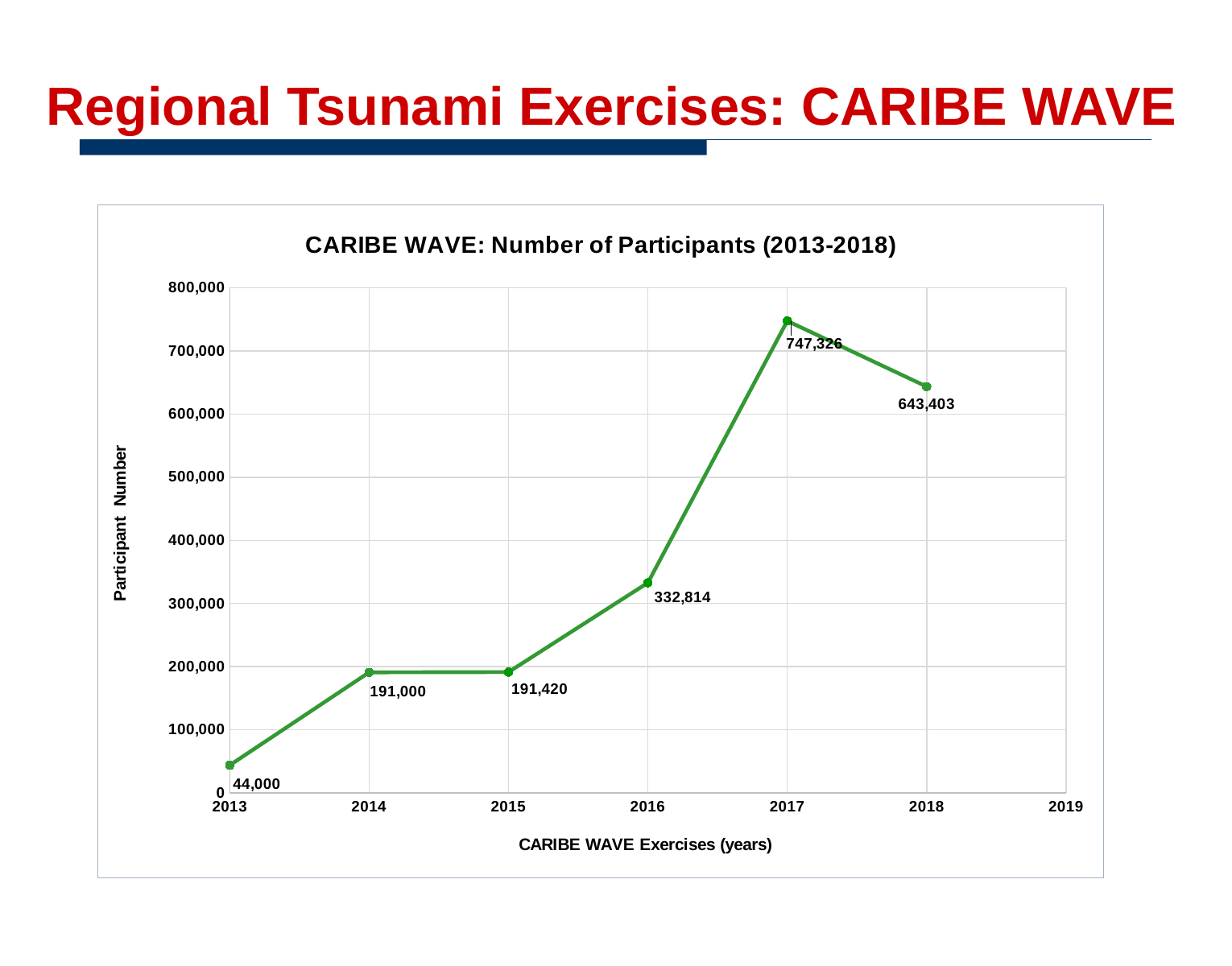
What kind of chart is shown on the slide? line chart What is the number of participants in 2016? 332,814 Which year has the lowest number of participants? 2013 How many data points are plotted on the chart? 6 What is the difference in participants between 2017 and 2018? 103,923 What is the number of participants in 2013? 44,000 What is the difference in participants between 2014 and 2013? 147,000 What is the number of participants in 2017? 747,326 What is the title of the chart? CARIBE WAVE: Number of Participants (2013-2018) Is the value for 2016 greater or less than 300,000? greater Which year had more participants, 2016 or 2018? 2018 Which year has the highest number of participants? 2017